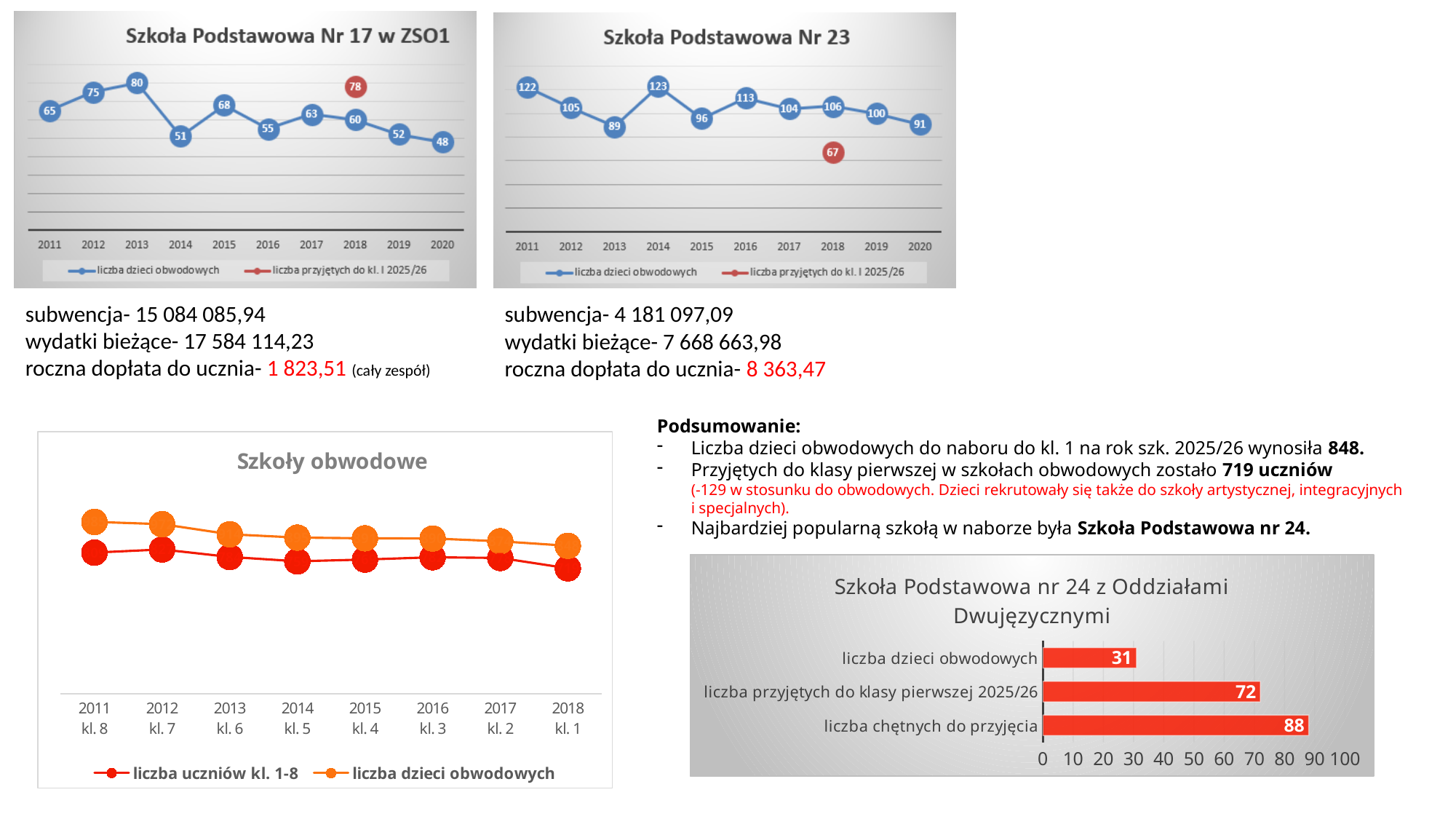
What kind of chart is 'Szkoła Podstawowa nr 24 z Oddziałami Dwujęzycznymi'? bar chart In the chart titled 'Szkoła Podstawowa nr 24 z Oddziałami Dwujęzycznymi', what is the value for 'liczba chętnych do przyjęcia'? 88 In the chart titled 'Szkoła Podstawowa Nr 23', what is the difference between the 'liczba dzieci obwodowych' values for 2011 and 2020? 31 In the chart titled 'Szkoła Podstawowa Nr 17 w ZSO1', what is the value of 'liczba dzieci obwodowych' for 2013? 80 In the chart titled 'Szkoła Podstawowa Nr 23', which year has the lowest value of 'liczba dzieci obwodowych'? 2013 In the chart titled 'Szkoła Podstawowa Nr 23', what is the value of 'liczba dzieci obwodowych' for 2014? 123 In the chart titled 'Szkoła Podstawowa Nr 23', how many series does the legend list? 2 In the chart titled 'Szkoła Podstawowa Nr 17 w ZSO1', which year has the lowest value of 'liczba dzieci obwodowych'? 2020 In the chart titled 'Szkoła Podstawowa nr 24 z Oddziałami Dwujęzycznymi', what is the difference between 'liczba przyjętych do klasy pierwszej 2025/26' and 'liczba dzieci obwodowych'? 41 In the chart titled 'Szkoła Podstawowa Nr 17 w ZSO1', what is the value of the red point 'liczba przyjętych do kl. I 2025/26'? 78 In the chart titled 'Szkoły obwodowe', which series is drawn in orange? liczba dzieci obwodowych In the chart titled 'Szkoły obwodowe', how many years are shown on the x axis? 8